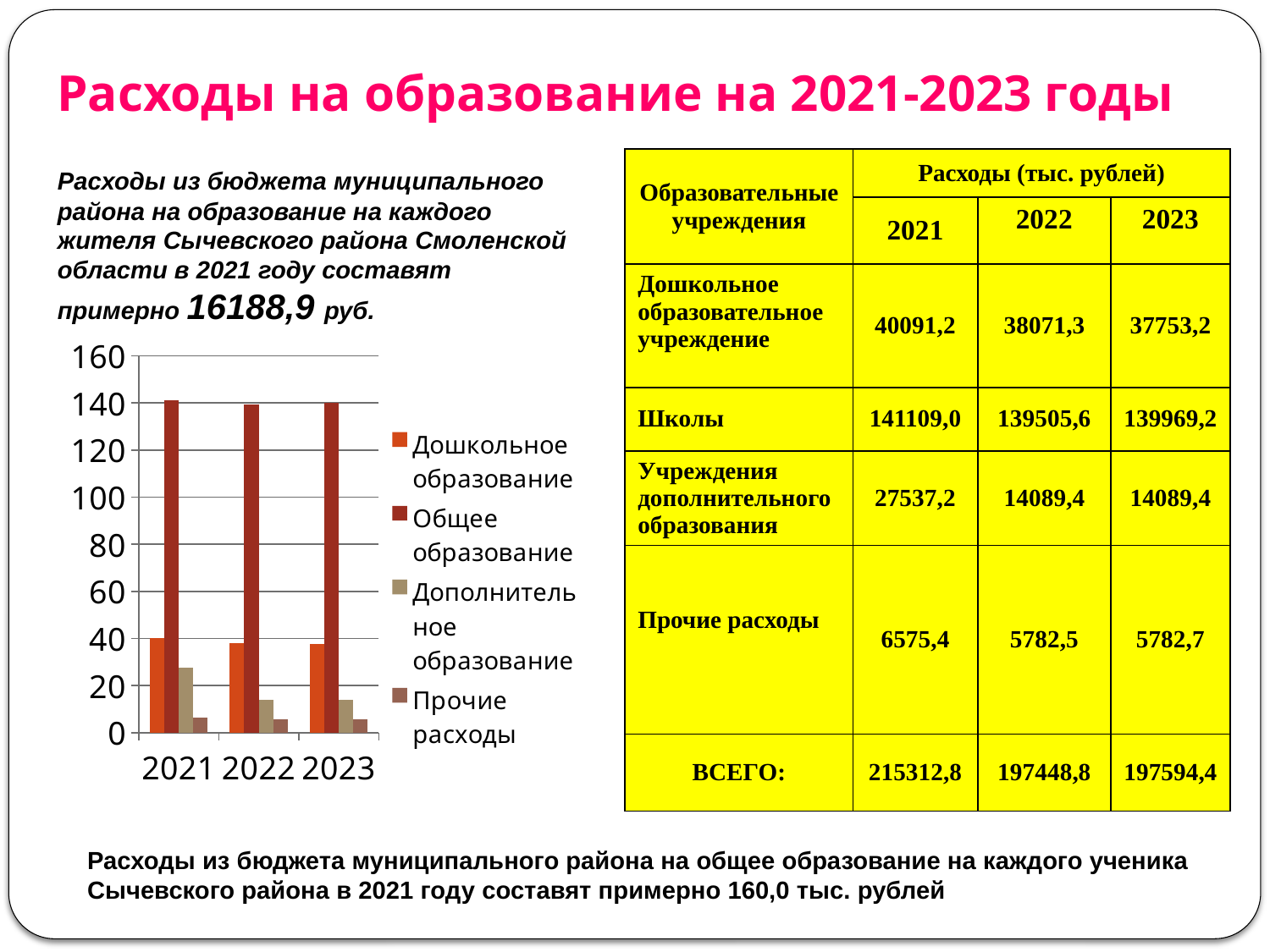
Which series has the shortest bar in 2023? Прочие расходы Which legend entry is shown in dark red? Общее образование How many series does the chart legend list? 4 Which series has the tallest bar in 2021? Общее образование Does the value for Дополнительное образование rise or fall from 2021 to 2022? fall Is the value for Дополнительное образование in 2022 greater or less than 20? less Is the value for Дошкольное образование in 2021 greater or less than 60? less How many years (categories) are shown on the x axis of the chart? 3 What kind of chart is shown on the slide? bar chart Is the value for Общее образование in 2021 greater or less than 120? greater In 2022, which is larger: Дошкольное образование or Дополнительное образование? Дошкольное образование